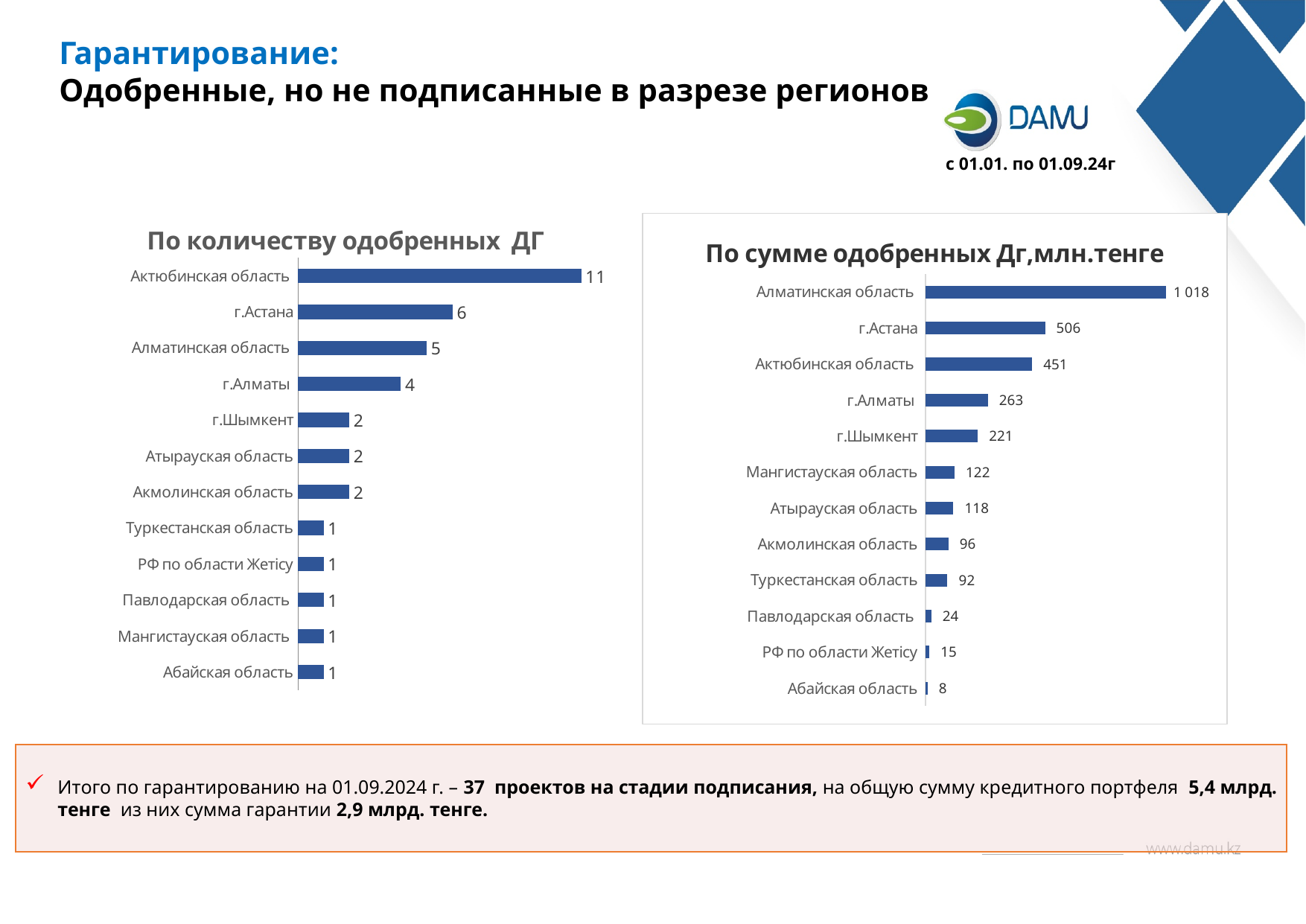
In the chart 'По количеству одобренных ДГ', what is the value for Актюбинская область? 11 In the chart 'По сумме одобренных Дг,млн.тенге', what is the value for Павлодарская область? 24 In the chart 'По количеству одобренных ДГ', which region has the highest value? Актюбинская область In the chart 'По сумме одобренных Дг,млн.тенге', which is larger: г.Астана or Актюбинская область? г.Астана In the chart 'По сумме одобренных Дг,млн.тенге', what is the difference between Мангистауская область and Атырауская область? 4 In the chart 'По сумме одобренных Дг,млн.тенге', which region has the lowest value? Абайская область What type of chart is 'По количеству одобренных ДГ'? Bar chart In the chart 'По сумме одобренных Дг,млн.тенге', what is the value for Алматинская область? 1 018 In the chart 'По количеству одобренных ДГ', what is the difference between г.Астана and г.Алматы? 2 In the chart 'По сумме одобренных Дг,млн.тенге', what is the value for г.Шымкент? 221 What is the title of the chart on the right side of the slide? По сумме одобренных Дг,млн.тенге In the chart 'По количеству одобренных ДГ', how many regions are listed? 12